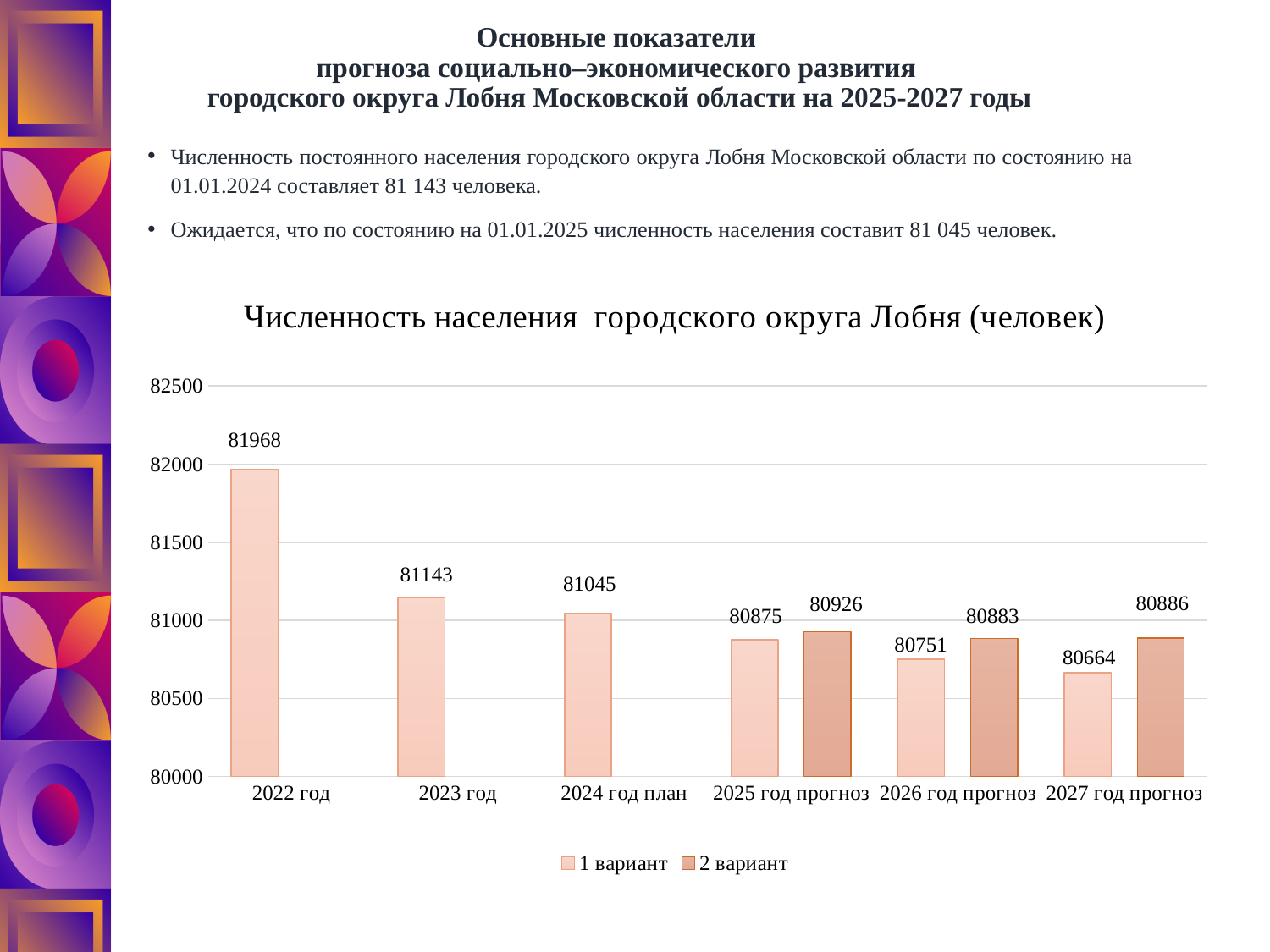
What is the difference between the 2 вариант and 1 вариант values for 2026 год прогноз? 132 How many categories are shown on the x axis? 6 Which category has the lowest value in the chart? 2027 год прогноз What kind of chart is shown on the slide? bar chart How many series does the legend list? 2 Which category has the highest value in the chart? 2022 год Which is larger for 2027 год прогноз: 1 вариант or 2 вариант? 2 вариант What is the difference between the values for 2022 год and 2023 год? 825 What is the value for 2022 год in the chart? 81968 What is the value of 2 вариант for 2025 год прогноз? 80926 Is the value for 2024 год план greater or less than 81000? greater What is the value of 1 вариант for 2027 год прогноз? 80664